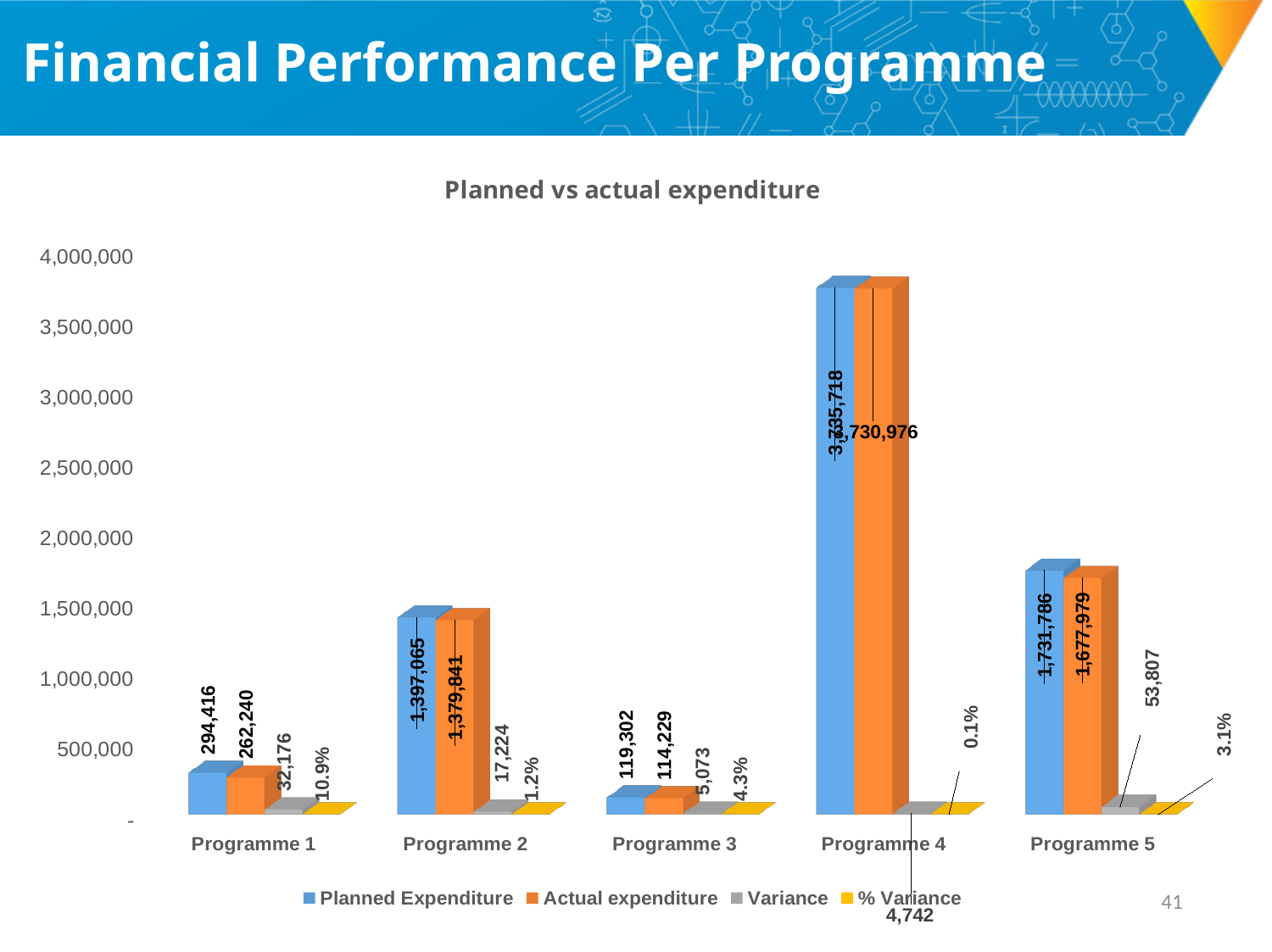
Which programme has the highest Planned Expenditure? Programme 4 What is the Planned Expenditure for Programme 1? 294,416 What is the % Variance for Programme 3? 4.3% What is the difference between Planned Expenditure and Actual expenditure for Programme 1? 32,176 How many programmes are shown on the x axis? 5 Which has the larger Planned Expenditure, Programme 2 or Programme 5? Programme 5 How many series does the legend list? 4 Is the Actual expenditure for Programme 4 greater or less than 3,500,000? greater What kind of chart is shown on the slide? bar chart What is the Variance for Programme 2? 17,224 What is the Actual expenditure for Programme 5? 1,677,979 Which programme has the lowest Actual expenditure? Programme 3